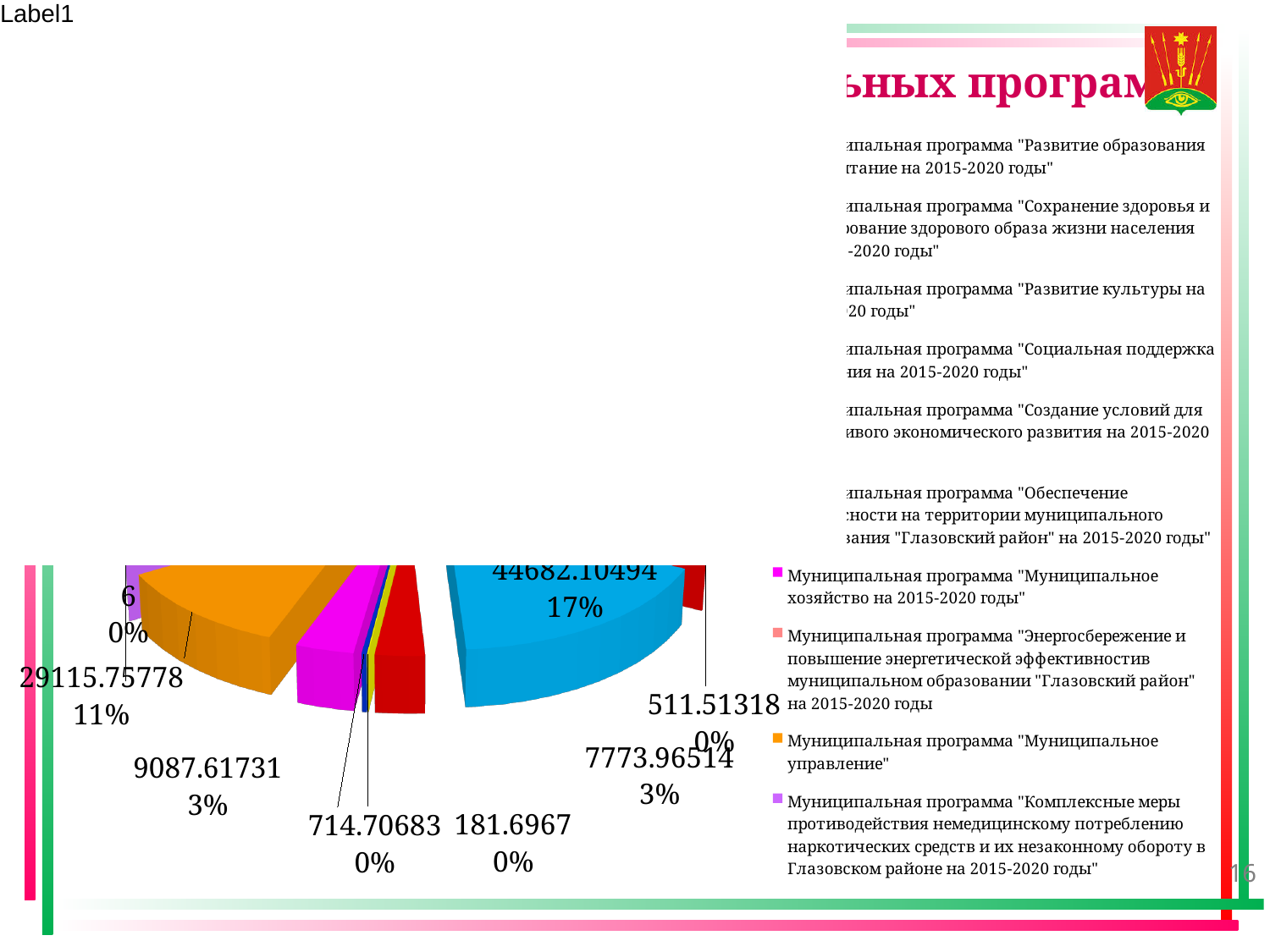
What percentage share is shown for the slice labelled 511.51318? 0% Which is larger, the slice labelled 44682.10494 or the slice labelled 29115.75778? 44682.10494 What is the difference between the values 9087.61731 and 7773.96514? 1313.65217 What value is shown for the orange slice, Муниципальная программа "Муниципальное управление"? 29115.75778 What colour is the legend marker for Муниципальная программа "Муниципальное хозяйство на 2015-2020 годы"? magenta What colour is the legend marker for Муниципальная программа "Муниципальное управление"? orange What percentage share is shown for the slice labelled 29115.75778? 11% What percentage share does the slice for Муниципальная программа "Муниципальное управление" have? 11% What kind of chart is shown on the slide? pie chart What is the difference between the values 44682.10494 and 29115.75778? 15566.34716